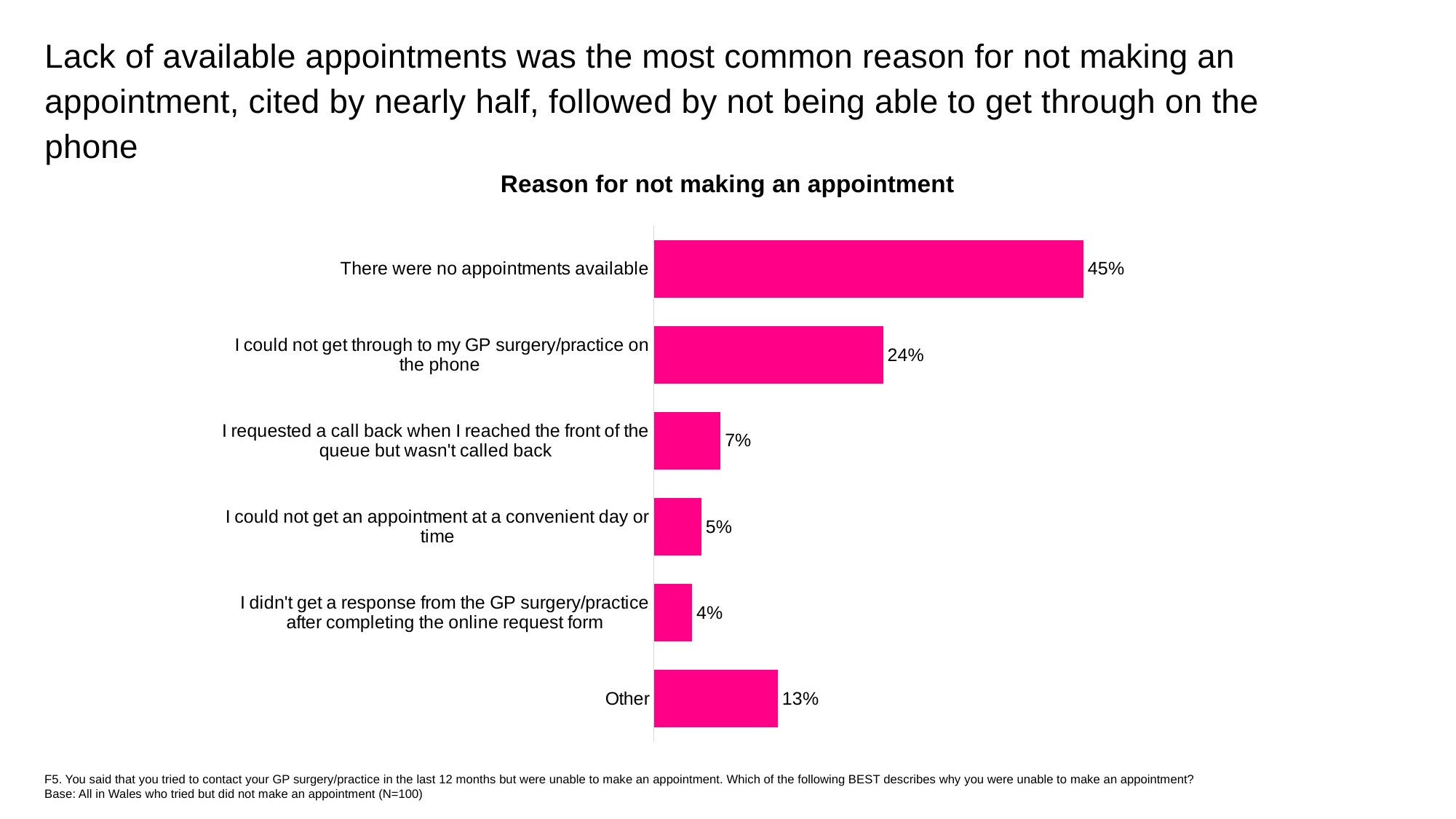
What is the difference between the value for 'Other' and 'I could not get an appointment at a convenient day or time'? 8% What percentage of respondents said there were no appointments available? 45% What is the difference between the value for 'There were no appointments available' and 'I could not get through to my GP surgery/practice on the phone'? 21% Which reason for not making an appointment has the lowest value? I didn't get a response from the GP surgery/practice after completing the online request form Which reason for not making an appointment has the highest value? There were no appointments available What percentage of respondents said they could not get through to their GP surgery/practice on the phone? 24% What kind of chart is shown on the slide? Bar chart What percentage said they didn't get a response from the GP surgery/practice after completing the online request form? 4% Which is larger: the value for 'I requested a call back when I reached the front of the queue but wasn't called back' or 'I could not get an appointment at a convenient day or time'? I requested a call back when I reached the front of the queue but wasn't called back What is the title of the chart? Reason for not making an appointment What is the value for 'Other'? 13% How many reasons (categories) are shown in the chart? 6